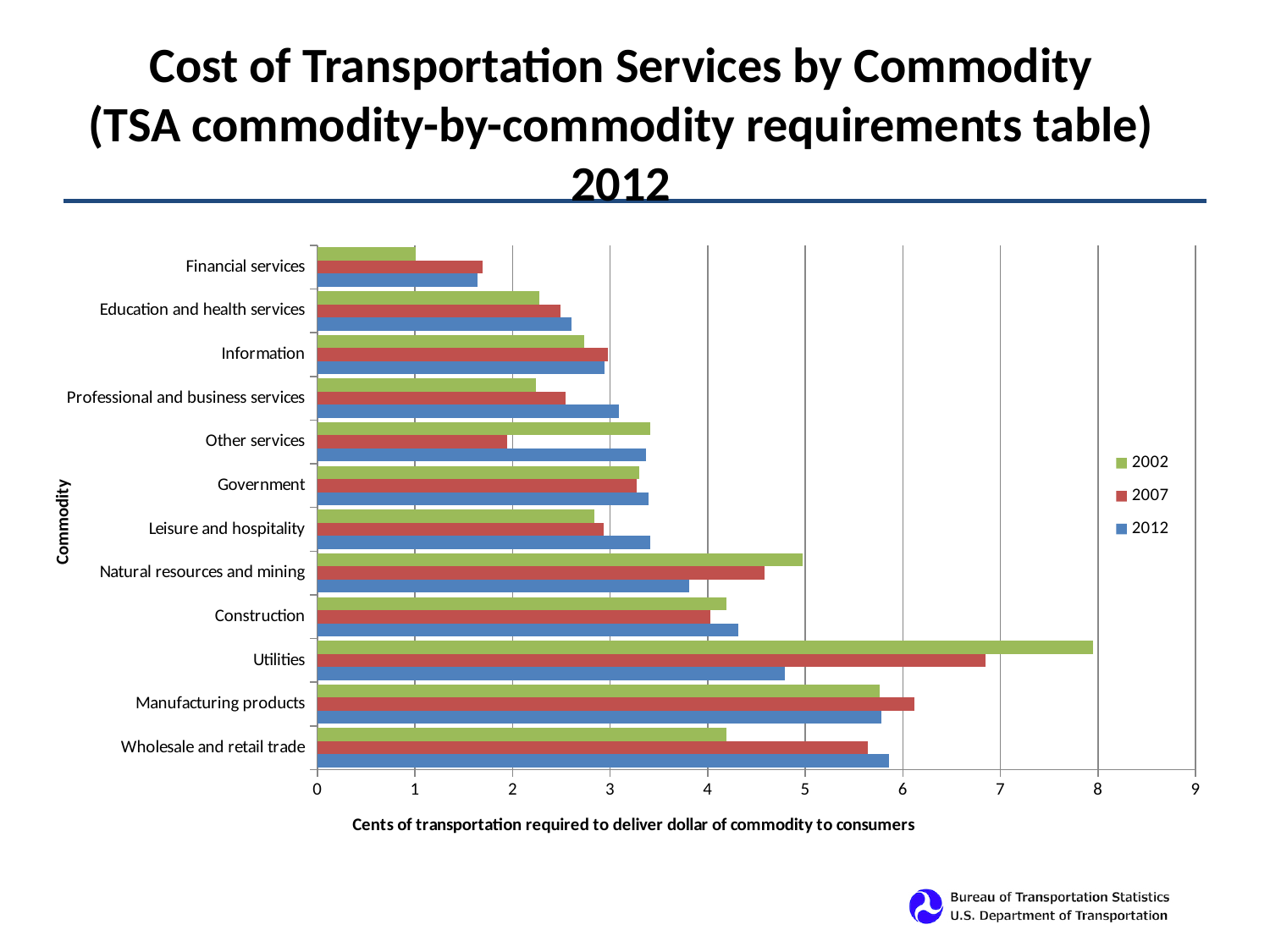
What is the label of the x axis? Cents of transportation required to deliver dollar of commodity to consumers Which commodity has the lowest 2012 value? Financial services For Wholesale and retail trade, which is larger: the 2002 value or the 2007 value? 2007 How many commodity categories are plotted on the chart? 12 Which commodity has the lowest 2002 value? Financial services Which commodity has the highest 2002 value? Utilities What kind of chart is shown on the slide? bar chart Which commodity has the highest 2007 value? Utilities Is the 2012 value for Utilities greater or less than 5? less How many series does the legend list? 3 Is the 2002 value for Utilities greater or less than 7? greater